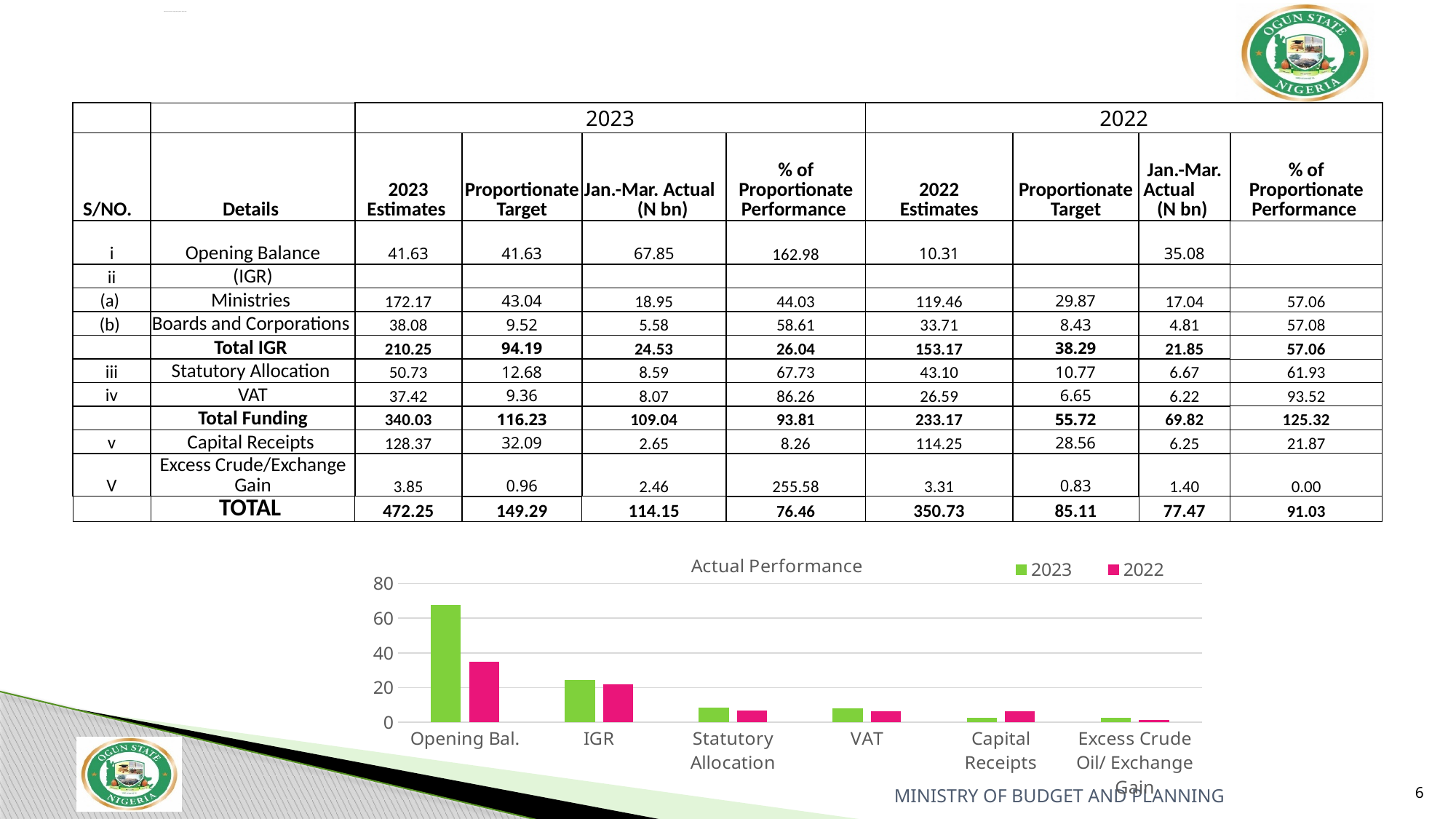
For Capital Receipts, which series has the larger bar, 2023 or 2022? 2022 Which category has the lowest value for the 2022 series in the chart? Excess Crude Oil/ Exchange Gain How many series does the chart legend list? 2 Is the 2023 value for Opening Bal. greater or less than 60? greater What is the title of the chart? Actual Performance Which category has the highest value for the 2023 series in the chart? Opening Bal. How many categories are shown on the x axis of the chart? 6 Is the 2022 value for Opening Bal. greater or less than 40? less Which category has the highest value for the 2022 series in the chart? Opening Bal. What type of chart is shown on the slide? bar chart For Opening Bal., which series has the larger bar, 2023 or 2022? 2023 Is the 2023 value for Statutory Allocation greater or less than 20? less